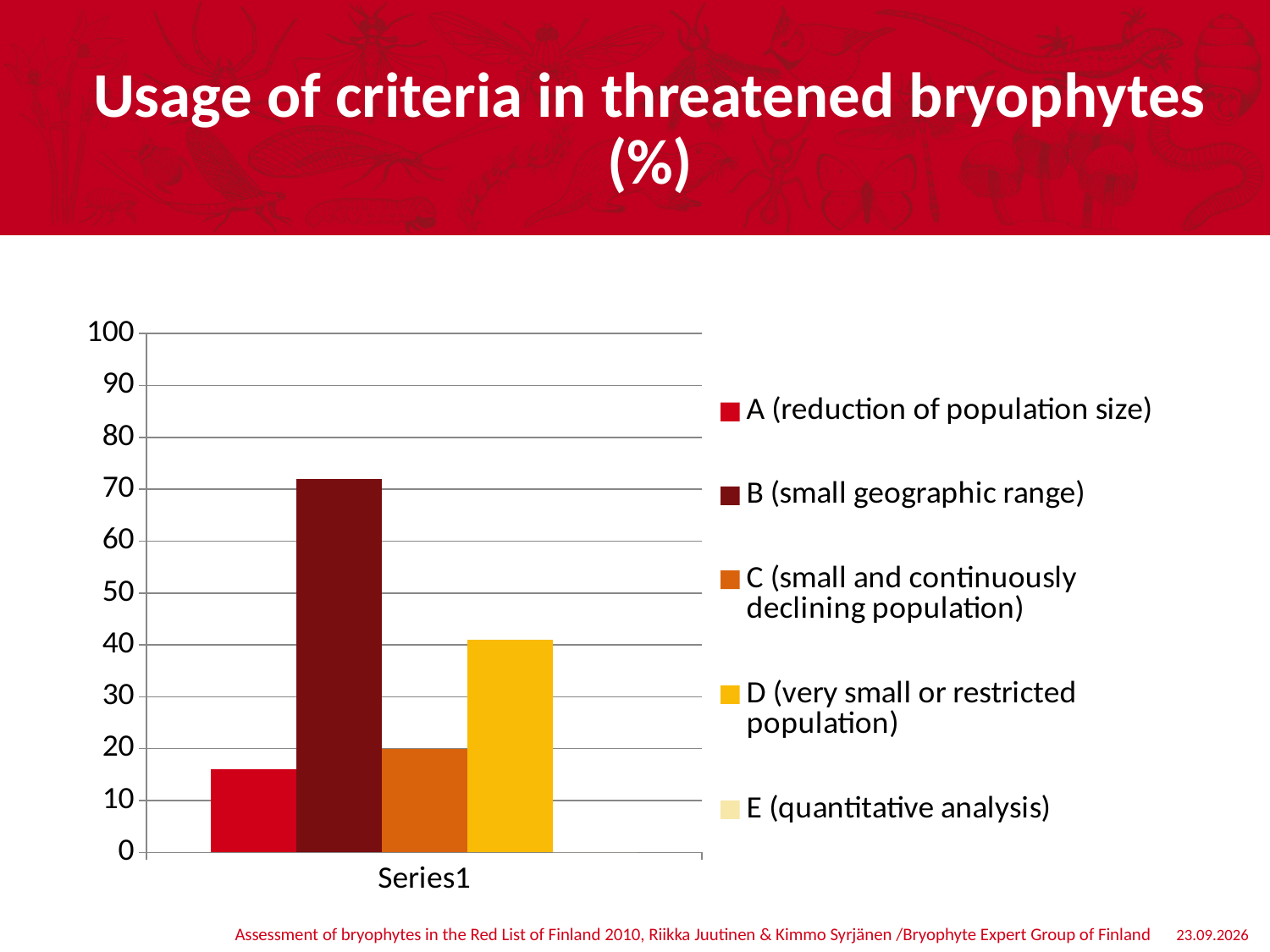
What is the title of the chart? Usage of criteria in threatened bryophytes (%) How many series does the legend list? 5 Is the value for D (very small or restricted population) greater or less than 50? less Which is larger, the value for C (small and continuously declining population) or the value for D (very small or restricted population)? D (very small or restricted population) Is the value for A (reduction of population size) greater or less than 10? greater What kind of chart is shown on the slide? bar chart Is the value for D (very small or restricted population) greater or less than 30? greater What is the highest value shown on the vertical axis? 100 Which is larger, the value for B (small geographic range) or the value for D (very small or restricted population)? B (small geographic range) Which criterion has the tallest bar? B (small geographic range)